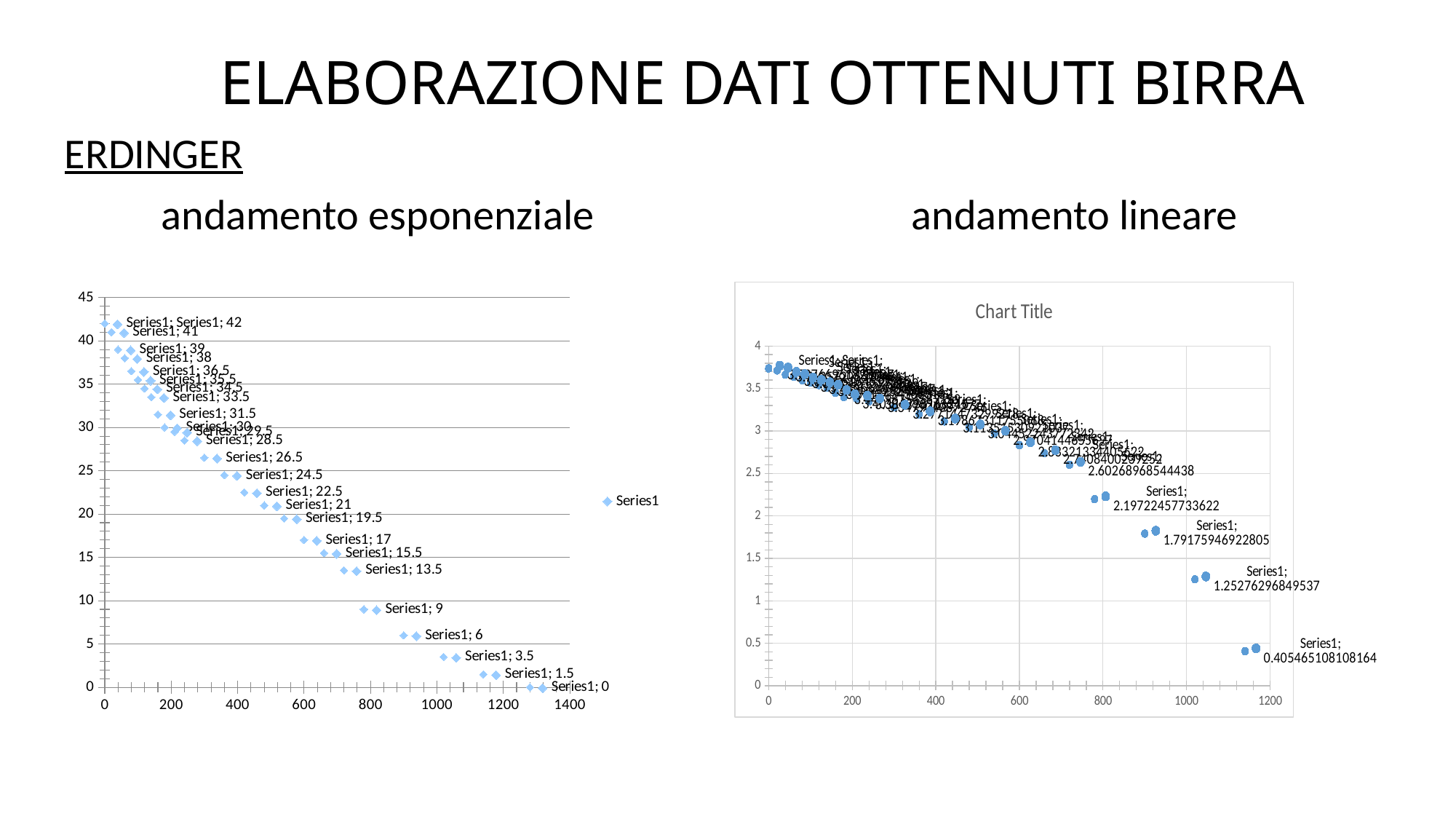
In the left chart 'andamento esponenziale', what is the lowest labelled value? 0 In the left chart 'andamento esponenziale', do the values rise or fall as the x axis increases? fall What title is shown on the right chart under 'andamento lineare'? Chart Title In the left chart 'andamento esponenziale', what is the highest labelled value? 42 What kind of chart is the left chart titled 'andamento esponenziale'? scatter chart In the right chart 'andamento lineare', what is the labelled value of the lowest point? 0.405465108108164 In the right chart 'andamento lineare', which is larger: the value labelled 1.79175946922805 or the value labelled 1.25276296849537? 1.79175946922805 In the left chart 'andamento esponenziale', what is the difference between the labelled values 42 and 38? 4 In the right chart 'andamento lineare', do the values rise or fall as the x axis increases? fall How many series does the legend of the left chart 'andamento esponenziale' list? 1 In the left chart 'andamento esponenziale', is the value of the points near x = 800 greater or less than 10? less In the right chart 'andamento lineare', what is the labelled value of the points near x = 800? 2.19722457733622